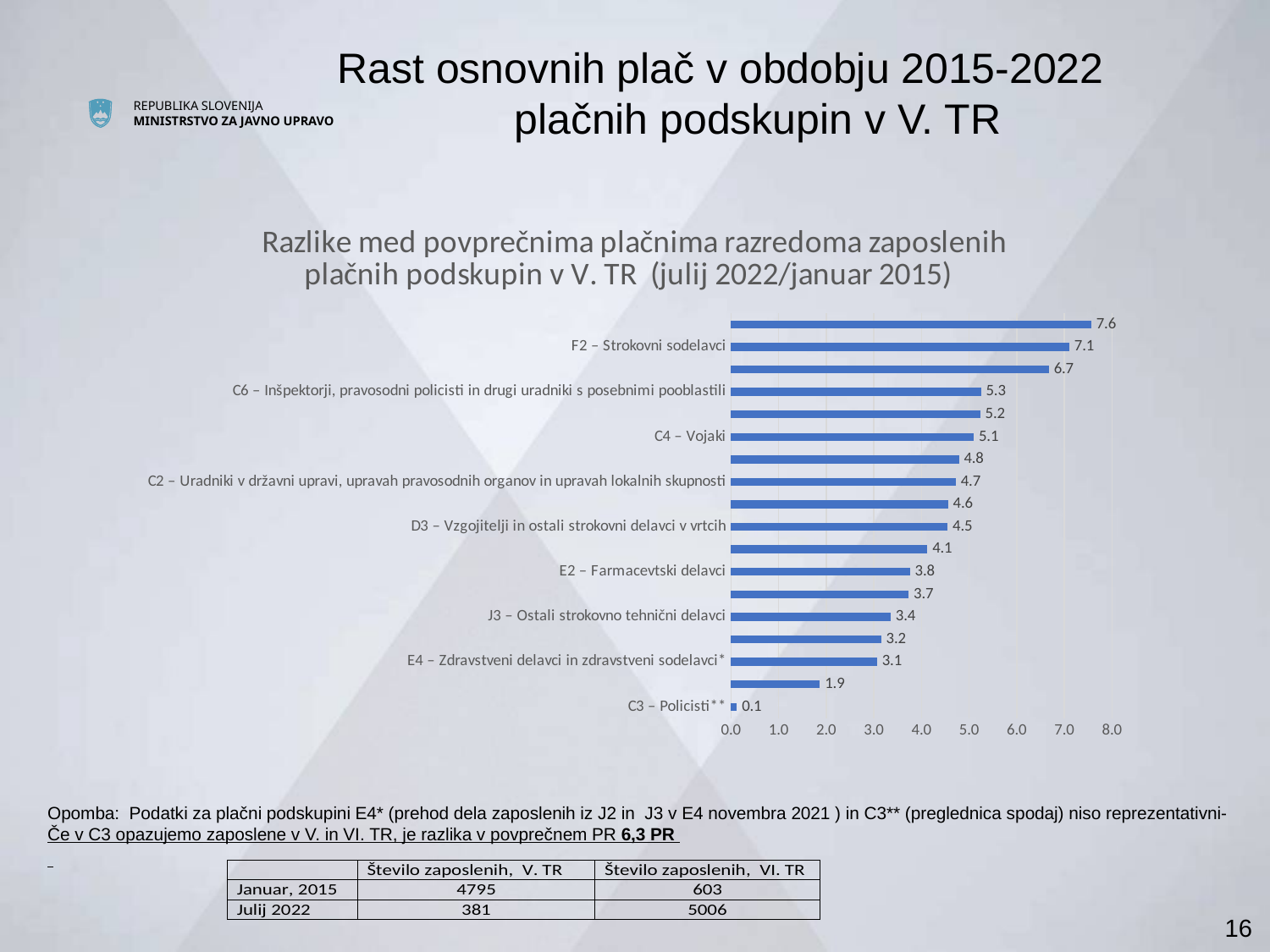
What is the value for J3 – Ostali strokovno tehnični delavci? 3.4 What kind of chart is shown on the slide? bar chart What is the value for C4 – Vojaki? 5.1 Which has the larger value: D3 – Vzgojitelji in ostali strokovni delavci v vrtcih or J3 – Ostali strokovno tehnični delavci? D3 – Vzgojitelji in ostali strokovni delavci v vrtcih Which labelled category has the lowest value? C3 – Policisti** What is the largest value shown on the chart? 7.6 Is the value for C2 – Uradniki v državni upravi, upravah pravosodnih organov in upravah lokalnih skupnosti greater or less than 4.0? greater What is the value for F2 – Strokovni sodelavci? 7.1 How many bars are plotted on the chart? 18 What is the difference between the values for F2 – Strokovni sodelavci and C6 – Inšpektorji, pravosodni policisti in drugi uradniki s posebnimi pooblastili? 1.8 What is the value for E2 – Farmacevtski delavci? 3.8 What is the value for C3 – Policisti**? 0.1